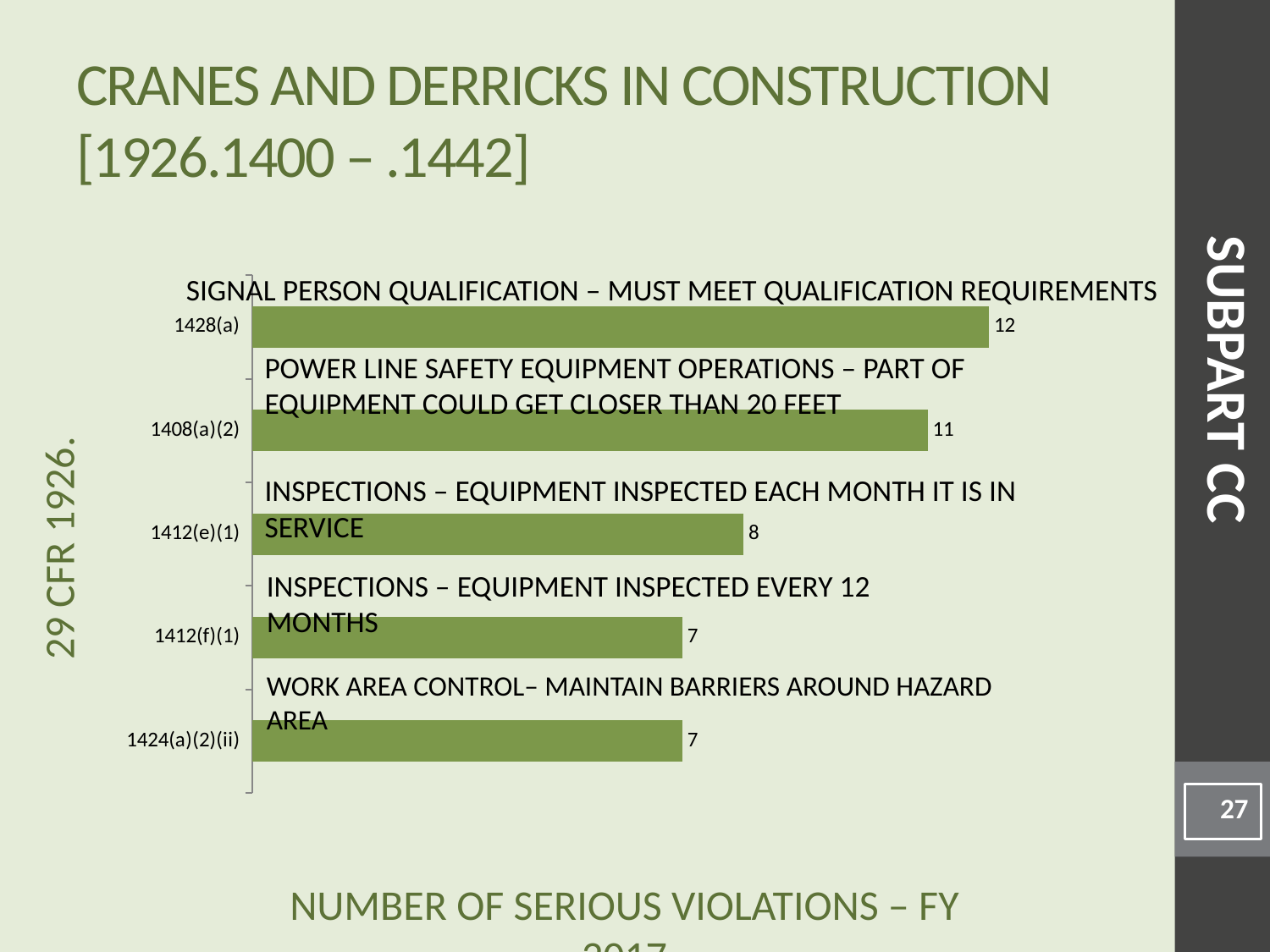
What is the label on the vertical axis of the chart? 29 CFR 1926. What is the number of serious violations for 1428(a)? 12 What is the number of serious violations for 1408(a)(2)? 11 What is the number of serious violations for 1412(f)(1)? 7 What is the difference in serious violations between 1408(a)(2) and 1412(f)(1)? 4 What type of chart is shown on the slide? Bar chart What is the difference in serious violations between 1428(a) and 1412(e)(1)? 4 What is the number of serious violations for 1424(a)(2)(ii)? 7 What is the number of serious violations for 1412(e)(1)? 8 How many standards (bars) are shown in the chart? 5 Which standard has the highest number of serious violations? 1428(a) Which has more serious violations, 1408(a)(2) or 1412(e)(1)? 1408(a)(2)